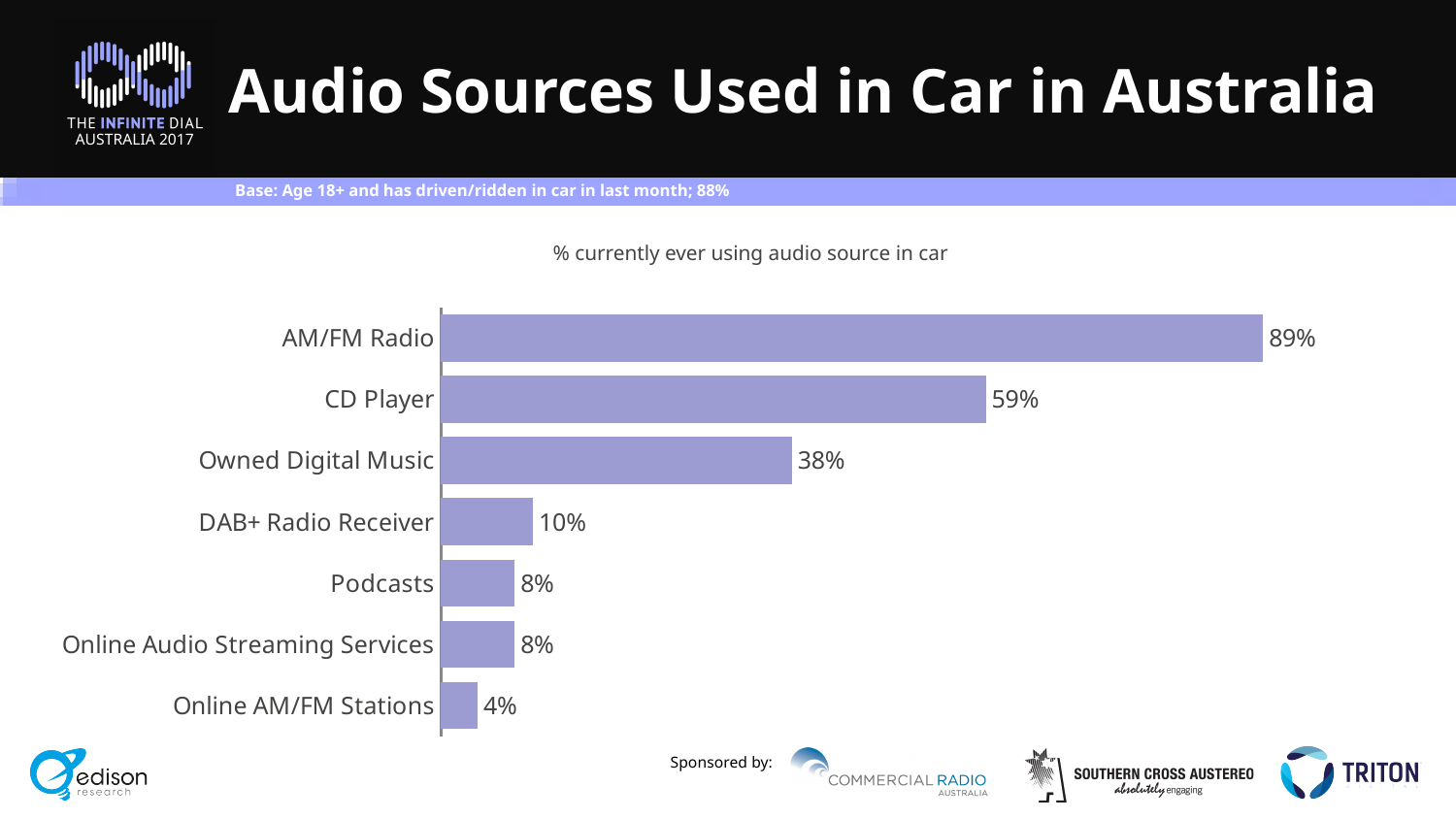
Which has a higher value, Owned Digital Music or DAB+ Radio Receiver? Owned Digital Music Which audio source has the lowest percentage of use in the car? Online AM/FM Stations What percentage is shown for Owned Digital Music? 38% What percentage is shown for Online AM/FM Stations? 4% What is the difference in percentage points between AM/FM Radio and CD Player? 30 What type of chart is used on this slide? Bar chart What percentage of respondents currently ever use AM/FM Radio as an audio source in the car? 89% How many audio source categories are shown in the chart? 7 What is the value shown for CD Player? 59% What is the subtitle shown above the chart? % currently ever using audio source in car Which audio source has the highest percentage of use in the car? AM/FM Radio What is the value for DAB+ Radio Receiver? 10%